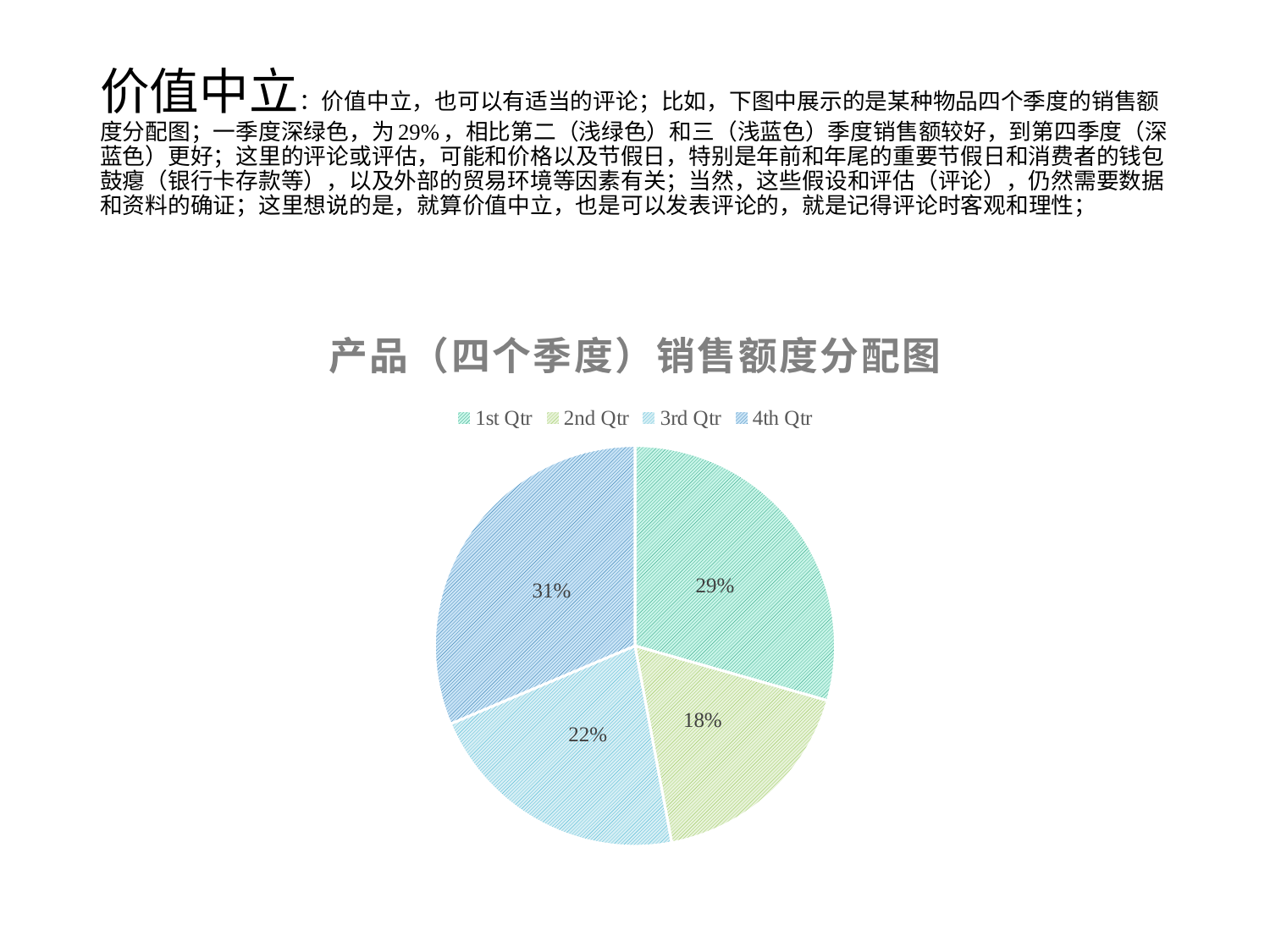
What is the difference in percentage points between the 4th Qtr and 2nd Qtr slices? 13 Which slice is larger, 1st Qtr or 3rd Qtr? 1st Qtr What is the title of the chart? 产品（四个季度）销售额度分配图 How many slices does the pie chart have? 4 What share of the pie does 2nd Qtr have? 18% Which quarter has the largest slice of the pie? 4th Qtr What share of the pie does 4th Qtr have? 31% What kind of chart is shown on the slide? Pie chart Which quarter has the smallest slice of the pie? 2nd Qtr What share of the pie does 3rd Qtr have? 22% How many entries does the legend list? 4 What share of the pie does 1st Qtr have? 29%